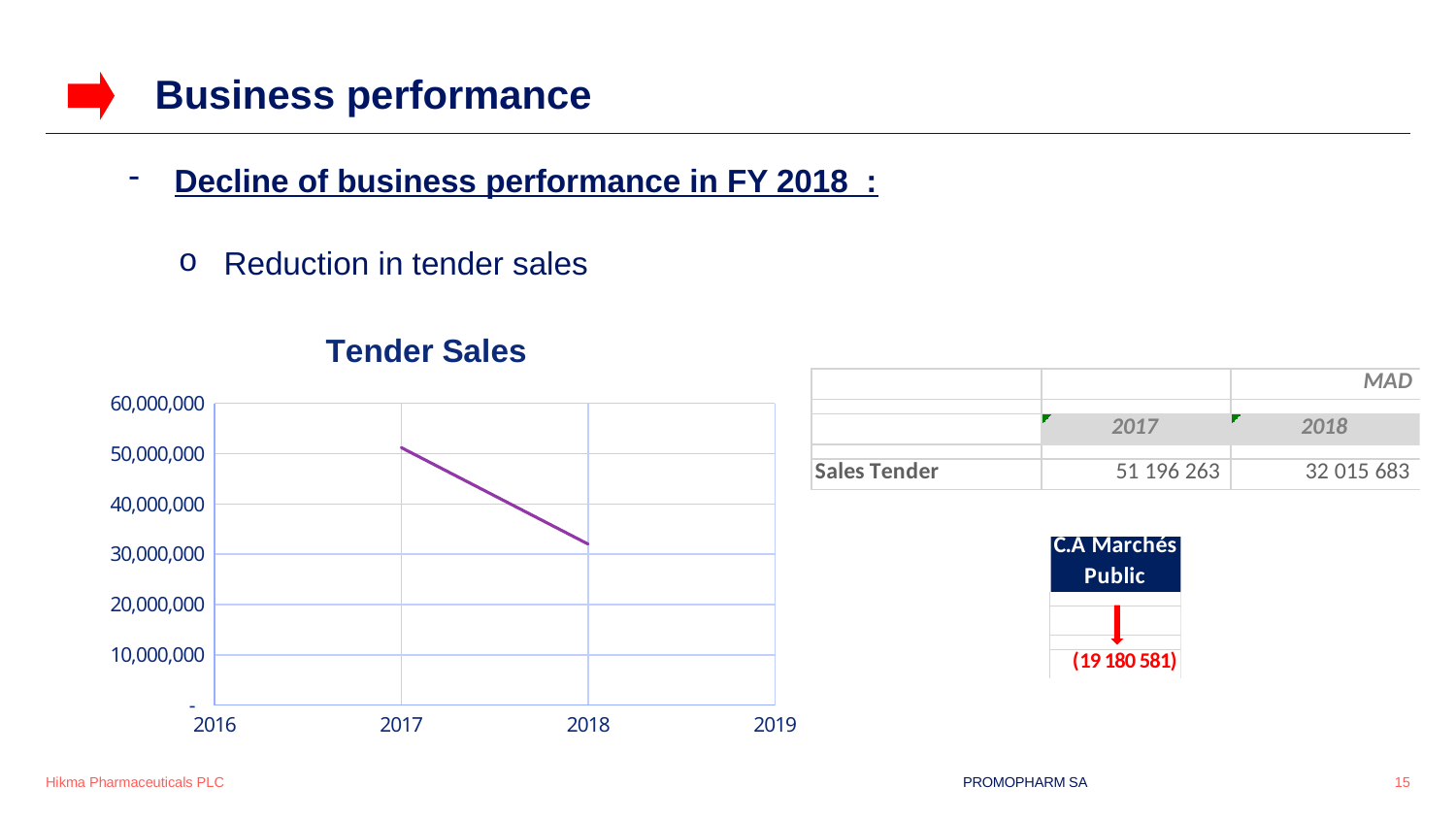
How many data points are plotted on the Tender Sales line? 2 What kind of chart is the Tender Sales chart? Line chart What is the change in Sales Tender from 2017 to 2018 as shown on the slide? (19 180 581) Is the Tender Sales value for 2018 greater or less than 40,000,000? less According to the table next to the chart, what were Sales Tender in 2017? 51 196 263 Is the Tender Sales value for 2018 greater or less than 30,000,000? greater Is the Tender Sales value for 2017 greater or less than 50,000,000? greater According to the table next to the chart, what were Sales Tender in 2018? 32 015 683 Do tender sales rise or fall from 2017 to 2018 in the Tender Sales chart? Fall Which year shows the lowest tender sales in the Tender Sales chart? 2018 Which year has the higher tender sales in the Tender Sales chart, 2017 or 2018? 2017 What is the title of the chart on the slide? Tender Sales